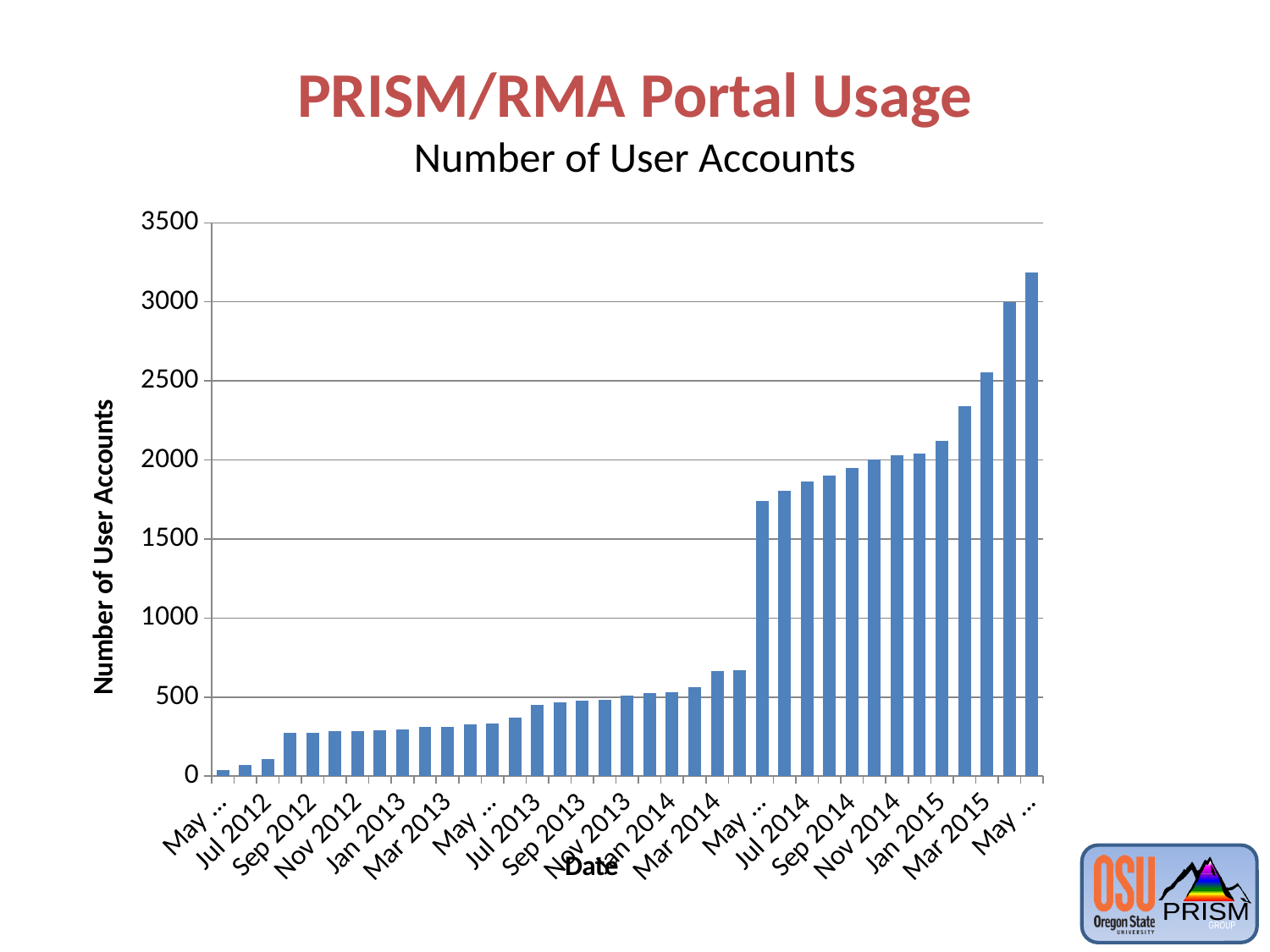
Which is larger, the value for Mar 2013 or the value for Mar 2014? Mar 2014 Is the value for Jul 2014 greater or less than 1500? greater Is the value for Mar 2015 greater or less than 2000? greater Do the number of user accounts generally rise or fall from left to right along the x axis? rise What is the label on the horizontal axis of the chart? Date Is the value for Jan 2013 greater or less than 500? less Which bar is the tallest, the first bar or the last bar on the right? the last bar Which bar is the shortest, the first bar on the left or the last bar? the first bar What is the title of the chart? Number of User Accounts What kind of chart is shown on the slide? bar chart